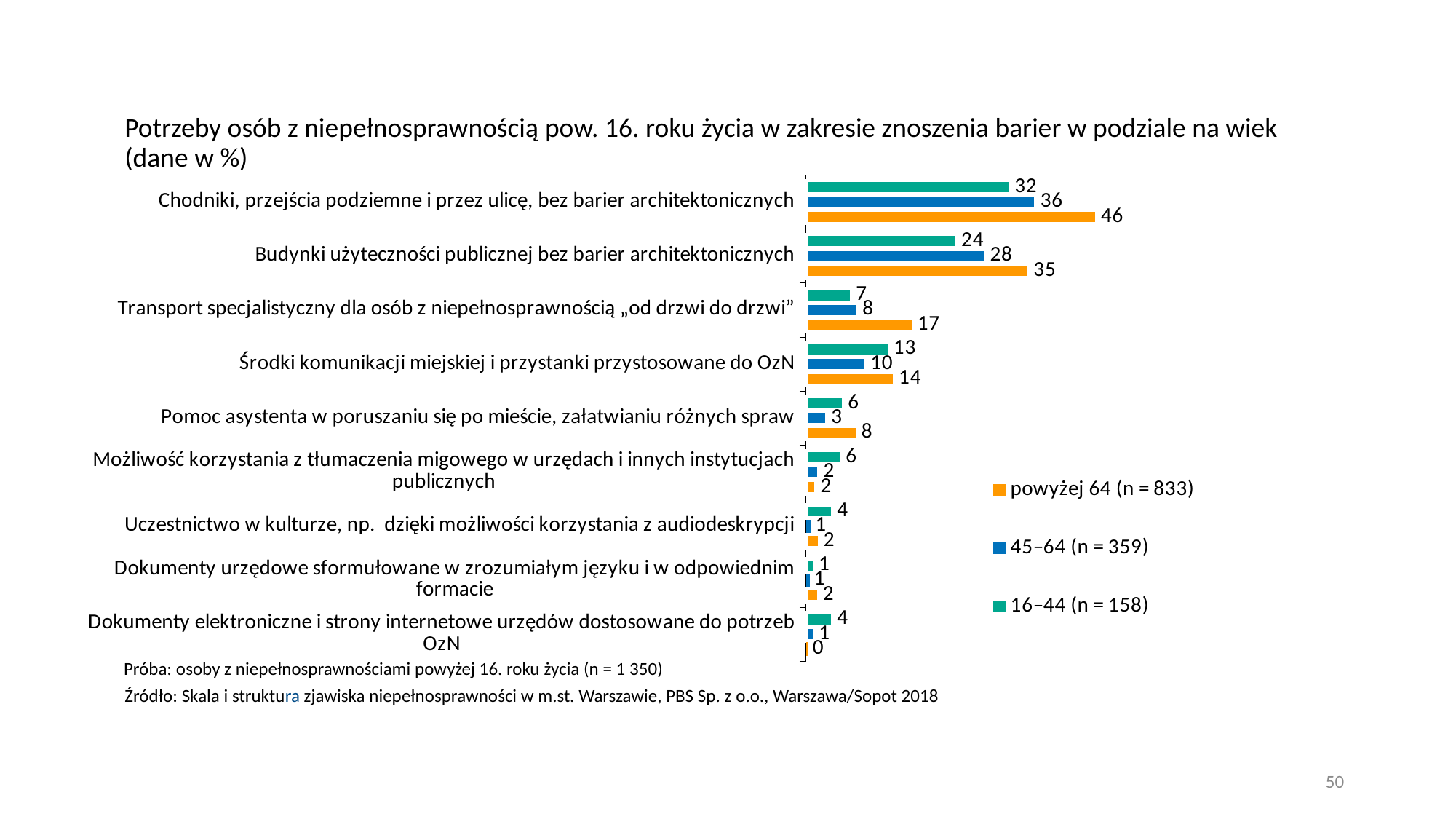
Which colour represents the '16–44' series in the legend? green What is the value for '16–44' for 'Budynki użyteczności publicznej bez barier architektonicznych'? 24 How many series does the legend list? 3 How many categories (needs) are shown on the chart? 9 What is the sample size shown in the legend for the '45–64' series? n = 359 What is the value for 'powyżej 64' for 'Chodniki, przejścia podziemne i przez ulicę, bez barier architektonicznych'? 46 For 'Pomoc asystenta w poruszaniu się po mieście, załatwianiu różnych spraw', which series has the larger value: '16–44' or '45–64'? 16–44 Which category has the lowest value for the 'powyżej 64' series? Dokumenty elektroniczne i strony internetowe urzędów dostosowane do potrzeb OzN What type of chart is shown on the slide? bar chart What is the difference between the 'powyżej 64' and '16–44' values for 'Transport specjalistyczny dla osób z niepełnosprawnością „od drzwi do drzwi”'? 10 What is the value for '45–64' for 'Środki komunikacji miejskiej i przystanki przystosowane do OzN'? 10 Which category has the highest value for the 'powyżej 64' series? Chodniki, przejścia podziemne i przez ulicę, bez barier architektonicznych